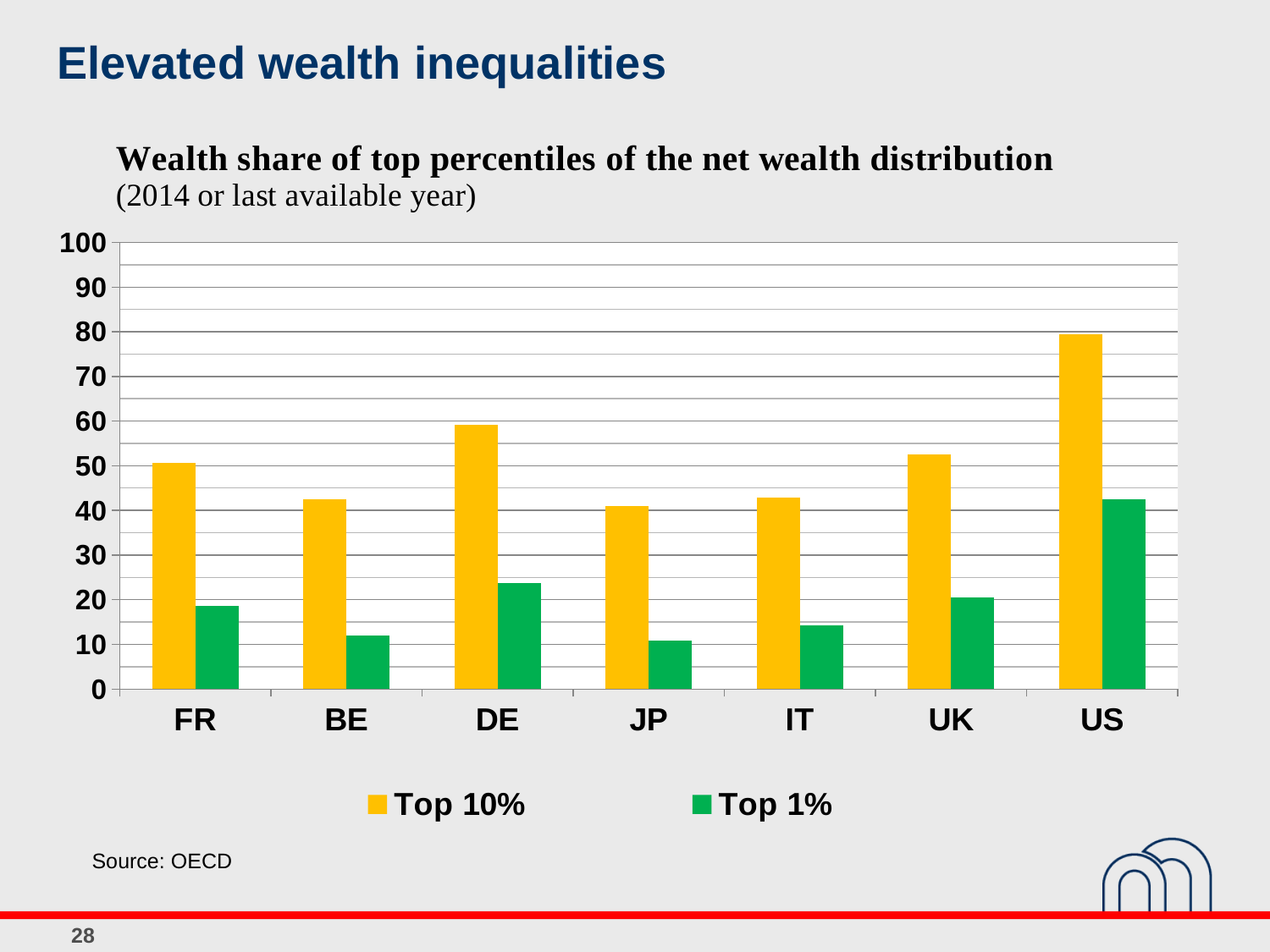
What are the two series named in the legend? Top 10% and Top 1% Which country has the highest Top 1% wealth share? US Is the Top 1% value for US greater or less than 30? greater Is the Top 10% value for US greater or less than 70? greater Which is larger, the Top 1% value for UK or the Top 1% value for IT? UK Is the Top 10% value for DE greater or less than 50? greater How many series does the legend list? 2 How many countries are shown on the x axis of the chart? 7 Which is larger, the Top 10% value for DE or the Top 10% value for UK? DE What kind of chart is shown on the slide? bar chart Which country has the highest Top 10% wealth share? US